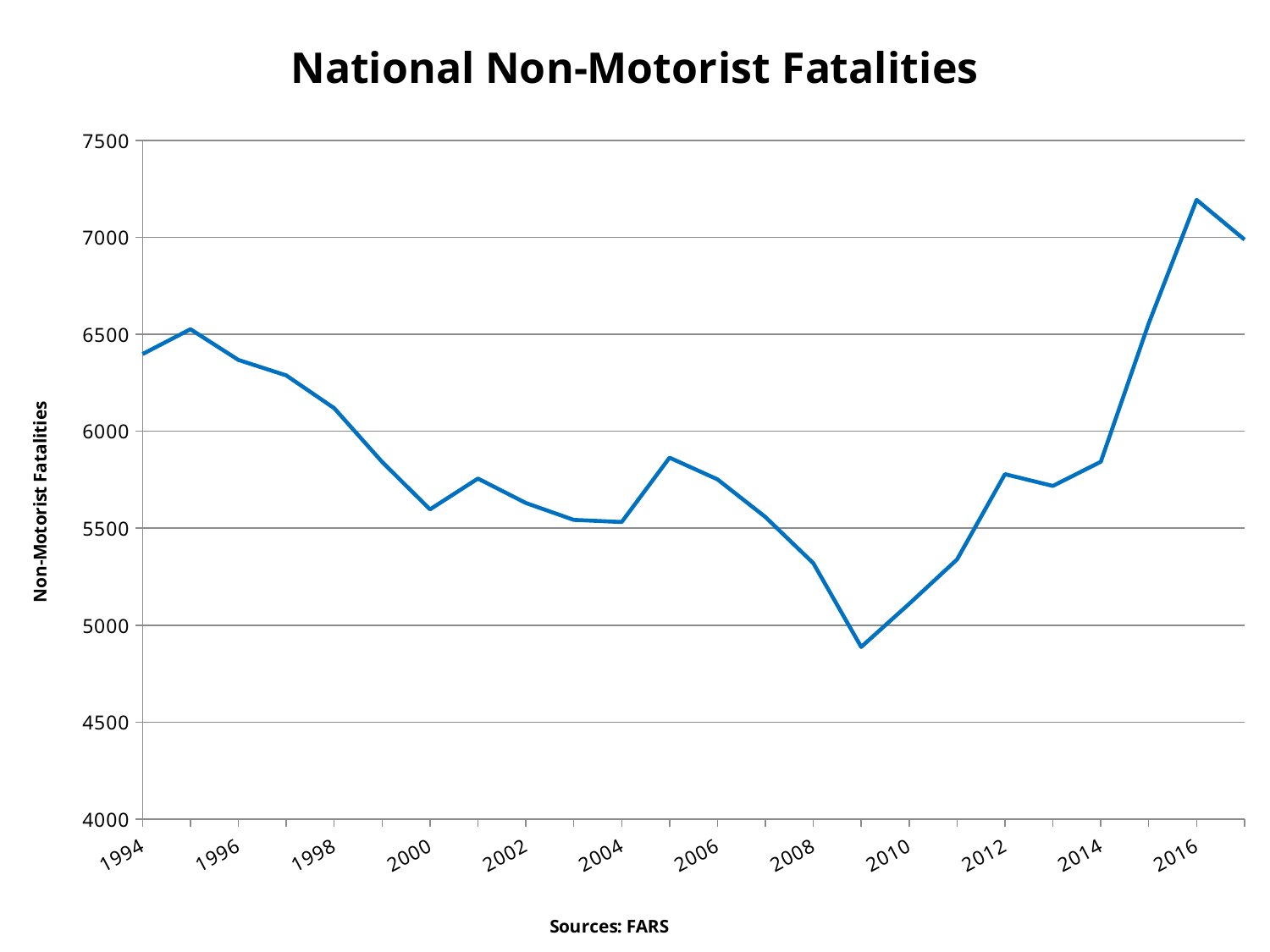
Is the value for 1994 greater or less than 6000? greater Do the values rise or fall between 2009 and 2016? rise Which year has the larger value, 2000 or 2009? 2000 Which year has the larger value, 1994 or 2016? 2016 Is the value for 2009 greater or less than 5000? less What is the title of the chart? National Non-Motorist Fatalities What is the label on the vertical axis of the chart? Non-Motorist Fatalities What kind of chart is shown on the slide? line chart In which year does the line reach its highest value? 2016 Is the value for 2008 greater or less than 5500? less In which year does the line reach its lowest value? 2009